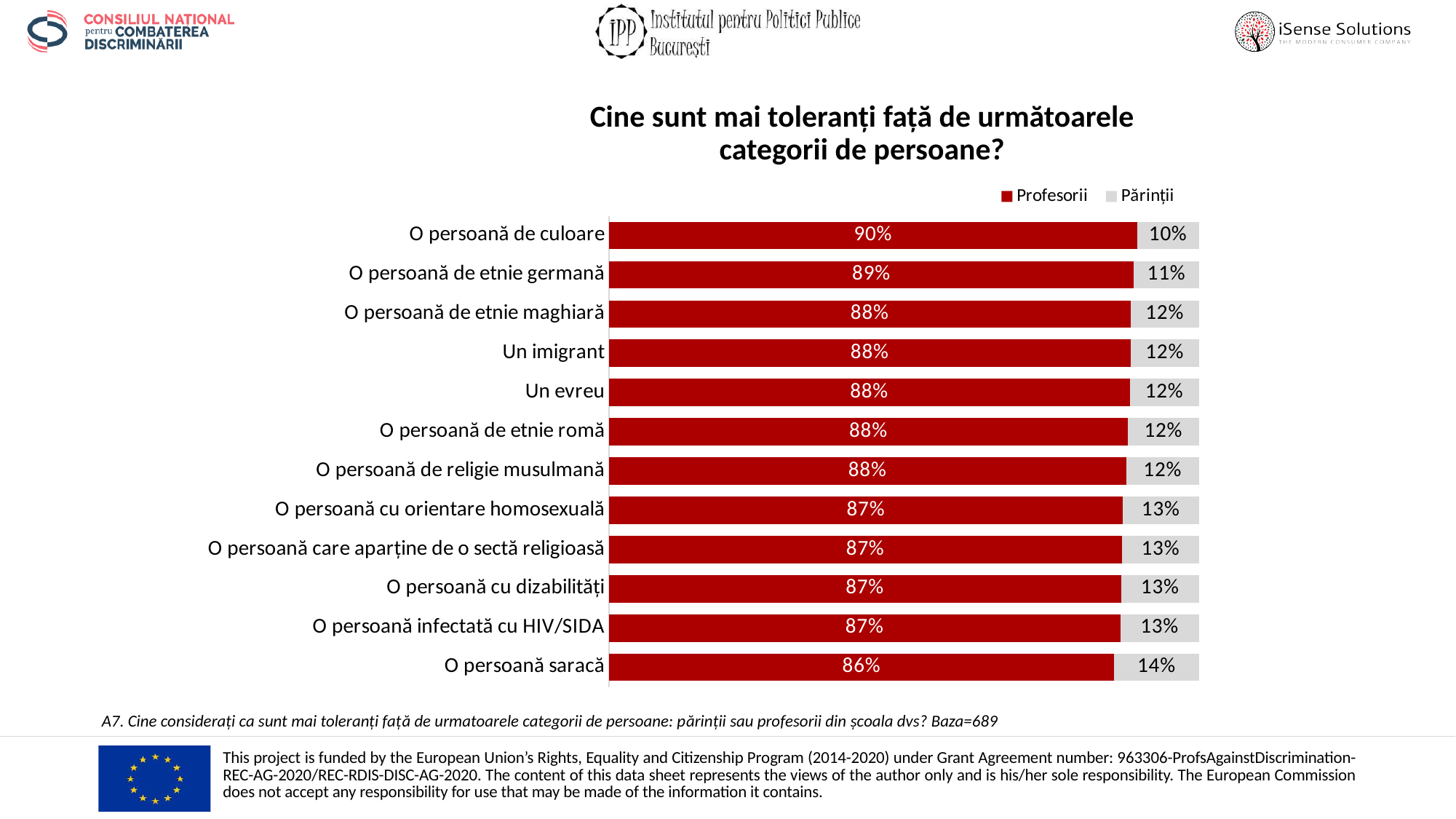
What kind of chart is shown on the slide? Bar chart How many series does the legend list? 2 How many categories are shown in the chart? 12 Which is larger: the Părinții value for "O persoană cu dizabilități" or for "O persoană de culoare"? O persoană cu dizabilități What is the Profesorii value for "O persoană infectată cu HIV/SIDA"? 87% Which category has the lowest Profesorii value? O persoană saracă What is the Profesorii value for "O persoană de culoare"? 90% Which category has the highest Părinții value? O persoană saracă What is the difference between the Profesorii value for "O persoană de culoare" and for "O persoană saracă"? 4% What is the Părinții value for "O persoană saracă"? 14% What is the Părinții value for "O persoană de etnie germană"? 11% Which category has the highest Profesorii value? O persoană de culoare